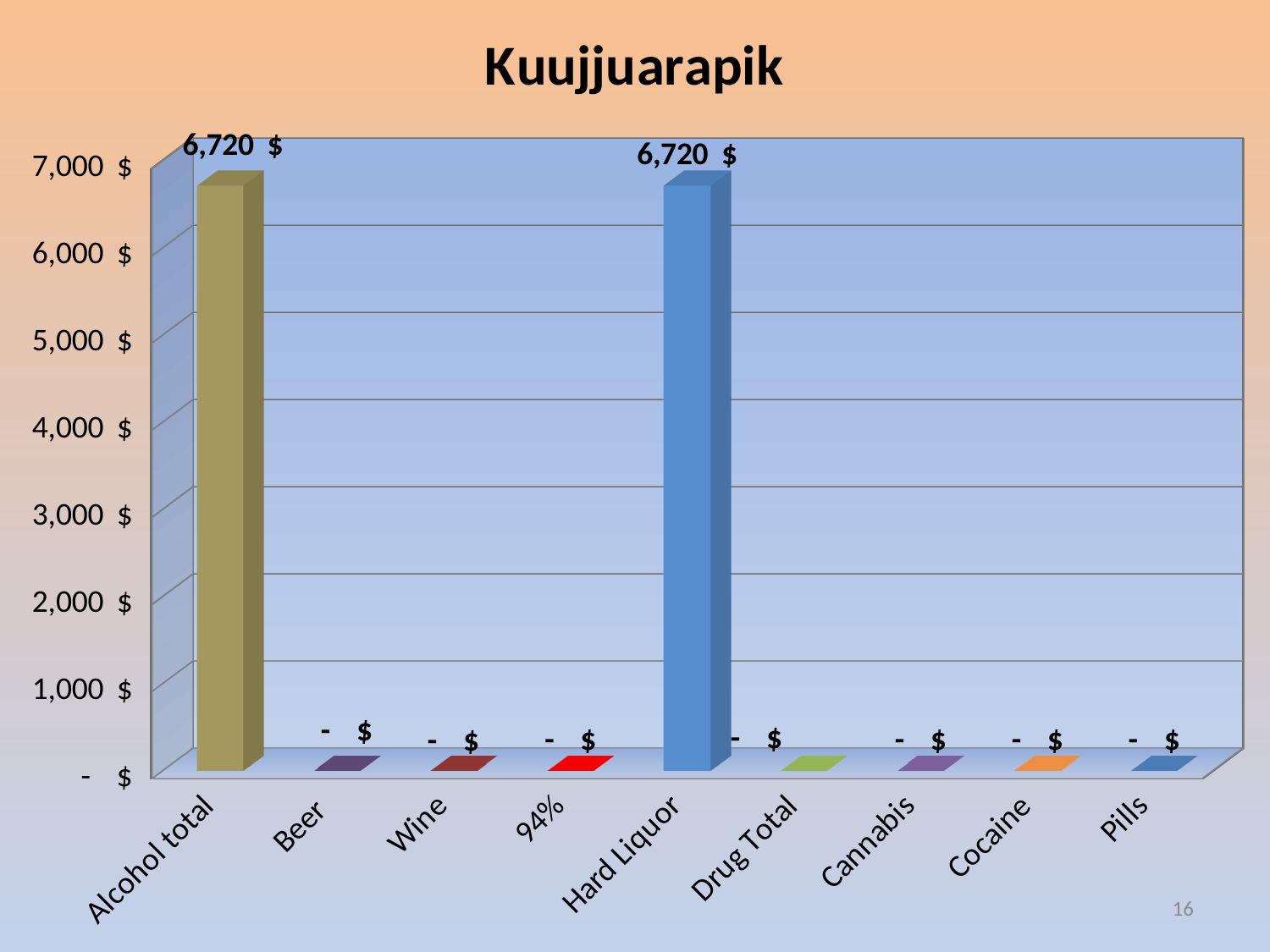
Is the value for Alcohol total greater or less than 7,000 $? less How many categories show a value of "- $"? 7 What is the value for Hard Liquor? 6,720 $ Is the value for Hard Liquor greater or less than 6,000 $? greater What kind of chart is shown on the slide? Bar chart What is the title of the chart? Kuujjuarapik What value is shown for Beer? - $ Which is larger, the value for Hard Liquor or the value for Wine? Hard Liquor Which is larger, the value for Alcohol total or the value for Cannabis? Alcohol total What is the value for Alcohol total? 6,720 $ What value is shown for Drug Total? - $ How many categories are shown on the x axis? 9